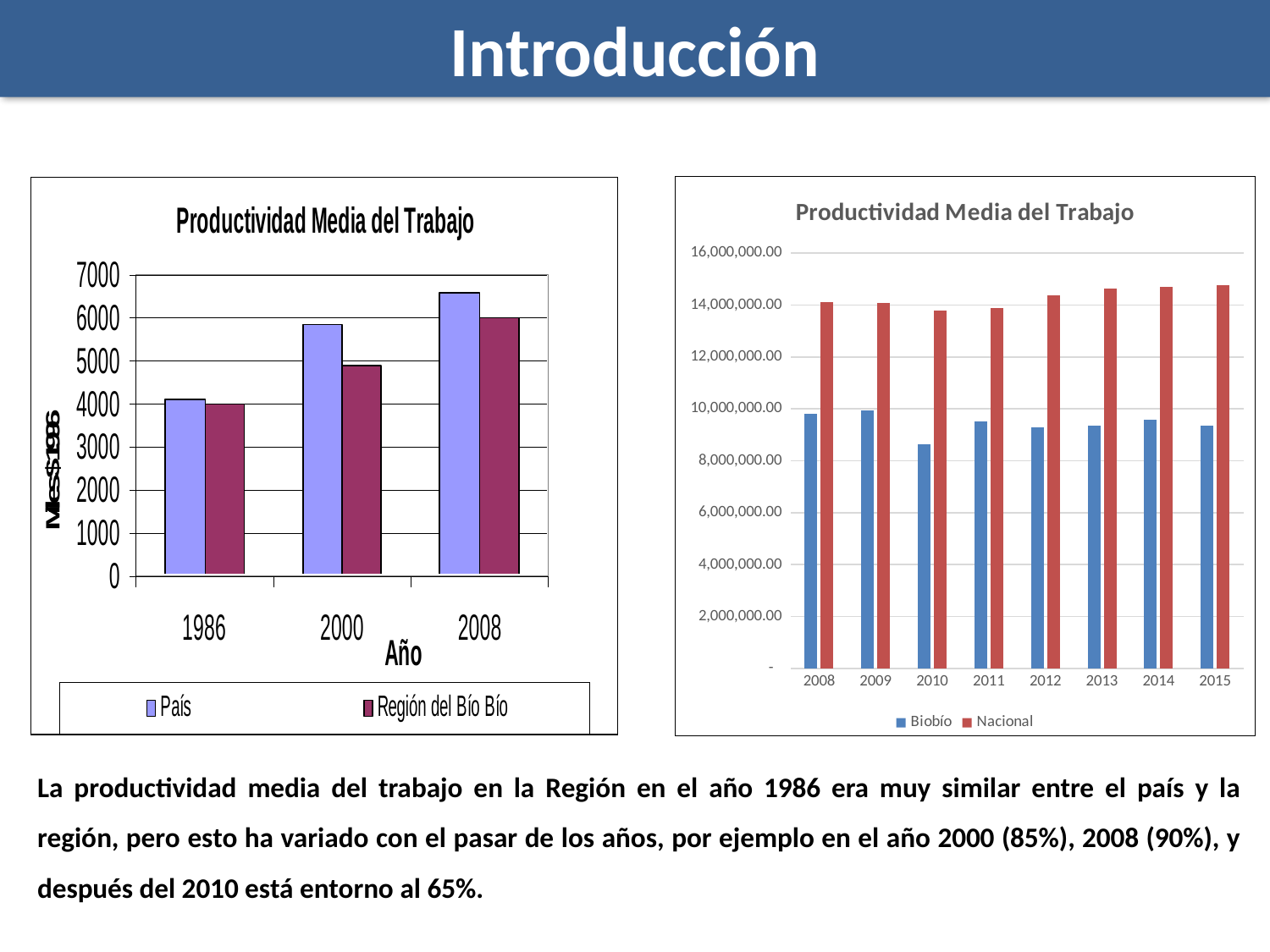
In the left chart, which year has the highest value for País? 2008 How many years are shown on the x axis of the right chart? 8 In the left chart, which is larger in 2000: País or Región del Bío Bío? País How many series does the legend of the left chart list? 2 In the left chart, is the value for País in 2008 greater or less than 6000? greater What kind of chart is the left chart on the slide? bar chart What is the y-axis label of the left chart? Miles $ 1996 In the right chart, is the value for Nacional in 2015 greater or less than 14,000,000.00? greater In the left chart, is the value for Región del Bío Bío in 2000 greater or less than 5000? less How many years are shown on the x axis of the left chart? 3 In the right chart, which year has the lowest value for Biobío? 2010 What are the two series listed in the legend of the right chart? Biobío and Nacional